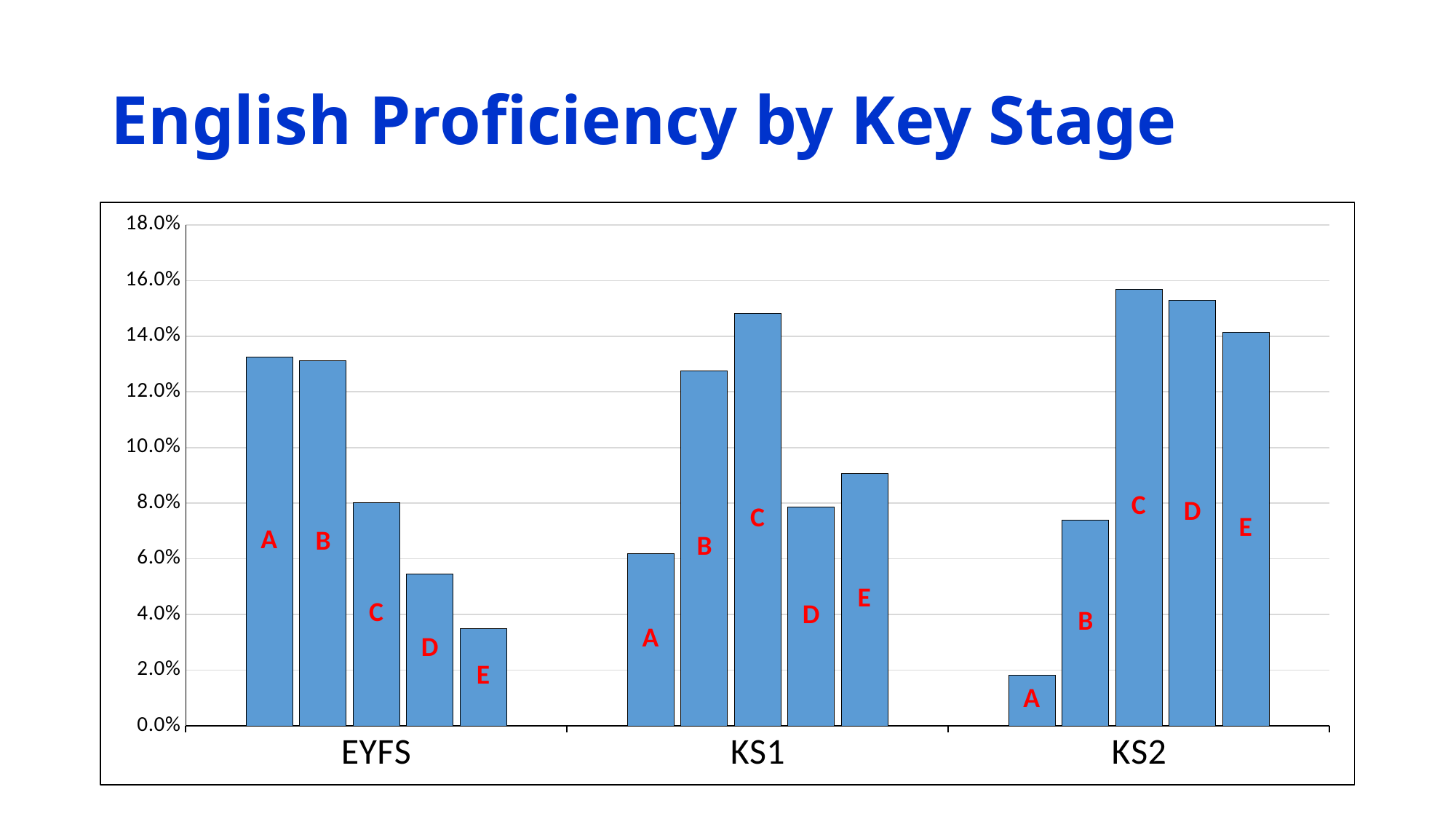
How many key stages are shown along the x axis? 3 Which band has the tallest bar in the KS2 group? C What kind of chart is shown on the slide? bar chart Which band has the shortest bar in the KS2 group? A Does the value for band A rise or fall from EYFS to KS1 to KS2? fall Is the value for band A in EYFS greater or less than 12.0%? greater Which band has the tallest bar in the KS1 group? C Which band has the shortest bar in the EYFS group? E What is the title of the chart? English Proficiency by Key Stage Which is larger: band C in EYFS or band C in KS1? band C in KS1 Is the value for band A in KS2 greater or less than 2.0%? less How many proficiency bands (labelled bars) are shown for each key stage? 5